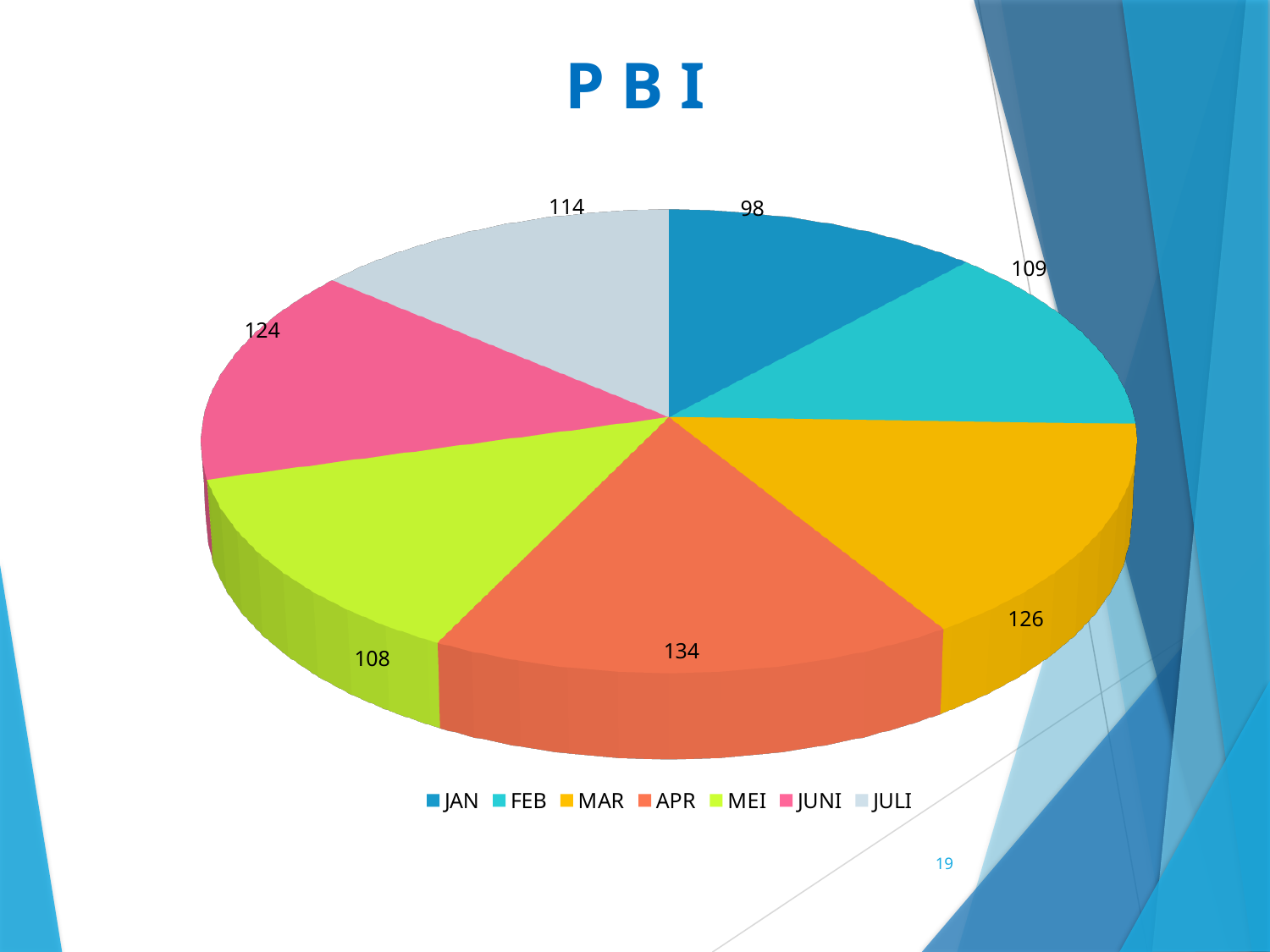
What is the value for APR? 134 How many slices does the pie chart have? 7 Which month has the smallest slice? JAN What is the total of all the slice values? 813 What is the title of the chart? P B I What is the value for JUNI? 124 Which month has the largest slice? APR What is the difference between the values for MAR and FEB? 17 Which is larger, the value for JULI or the value for MEI? JULI What type of chart is shown on the slide? pie chart What is the value for JAN? 98 Which colour represents MAR in the legend? yellow/orange